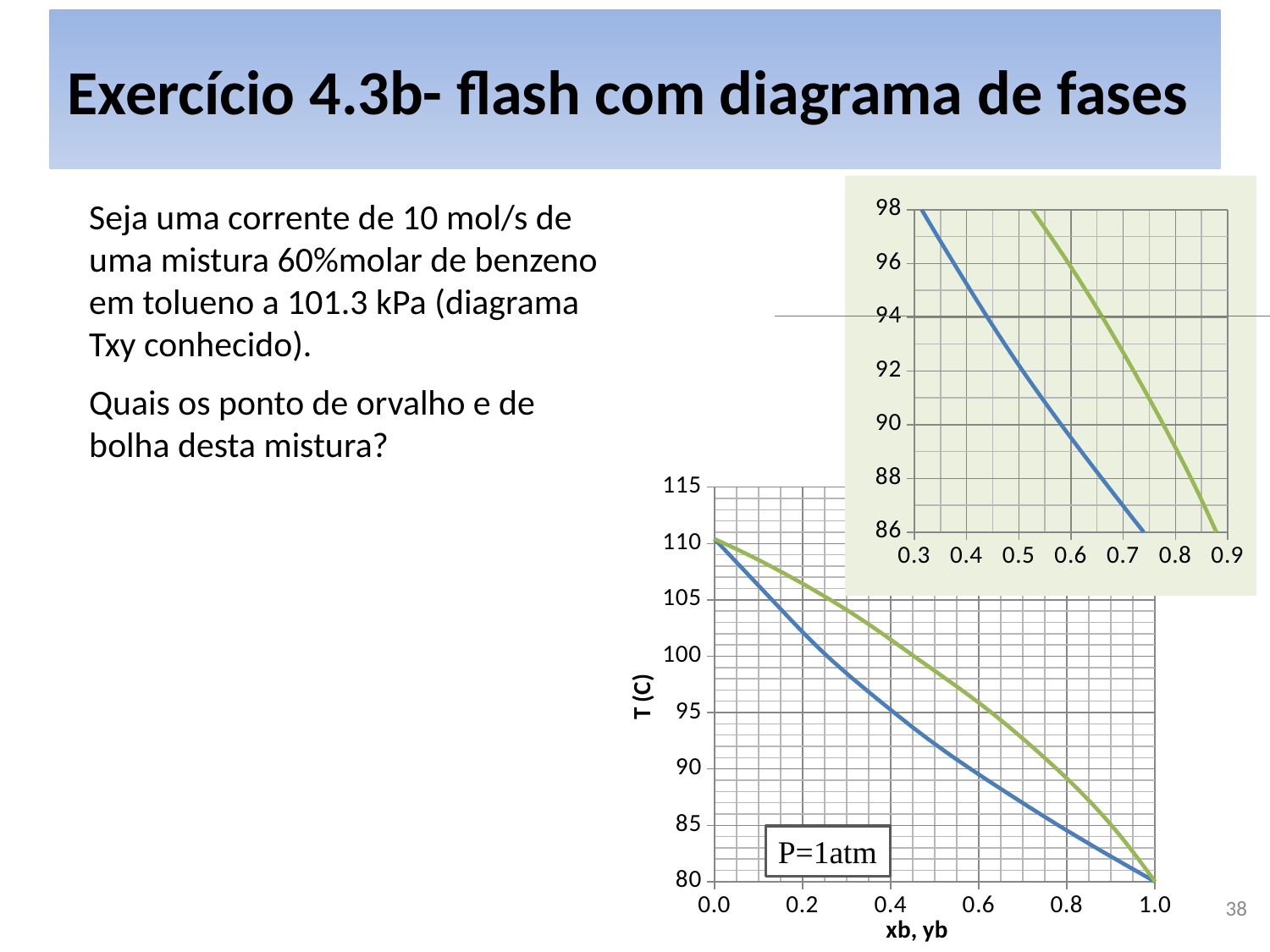
On the large bottom chart, is the value of the green line at xb, yb = 0.2 greater or less than 105? greater On the inset chart at the top right, do the lines rise or fall as the x value increases from 0.3 to 0.9? fall On the large bottom chart, at xb, yb = 0.4, which line has the higher temperature, the blue line or the green line? green line On the large bottom chart, what is the title of the y axis? T (C) On the large bottom chart, is the value of the blue line at xb, yb = 0.2 greater or less than 100? greater On the inset chart at the top right, is the value of the green line at 0.6 greater or less than 94? greater On the large bottom chart, do the plotted lines rise or fall as xb, yb increases from 0.0 to 1.0? fall On the large bottom chart, what is the title of the x axis? xb, yb What kind of chart is the large chart at the bottom right of the slide? line chart On the large bottom chart, how many lines are plotted? 2